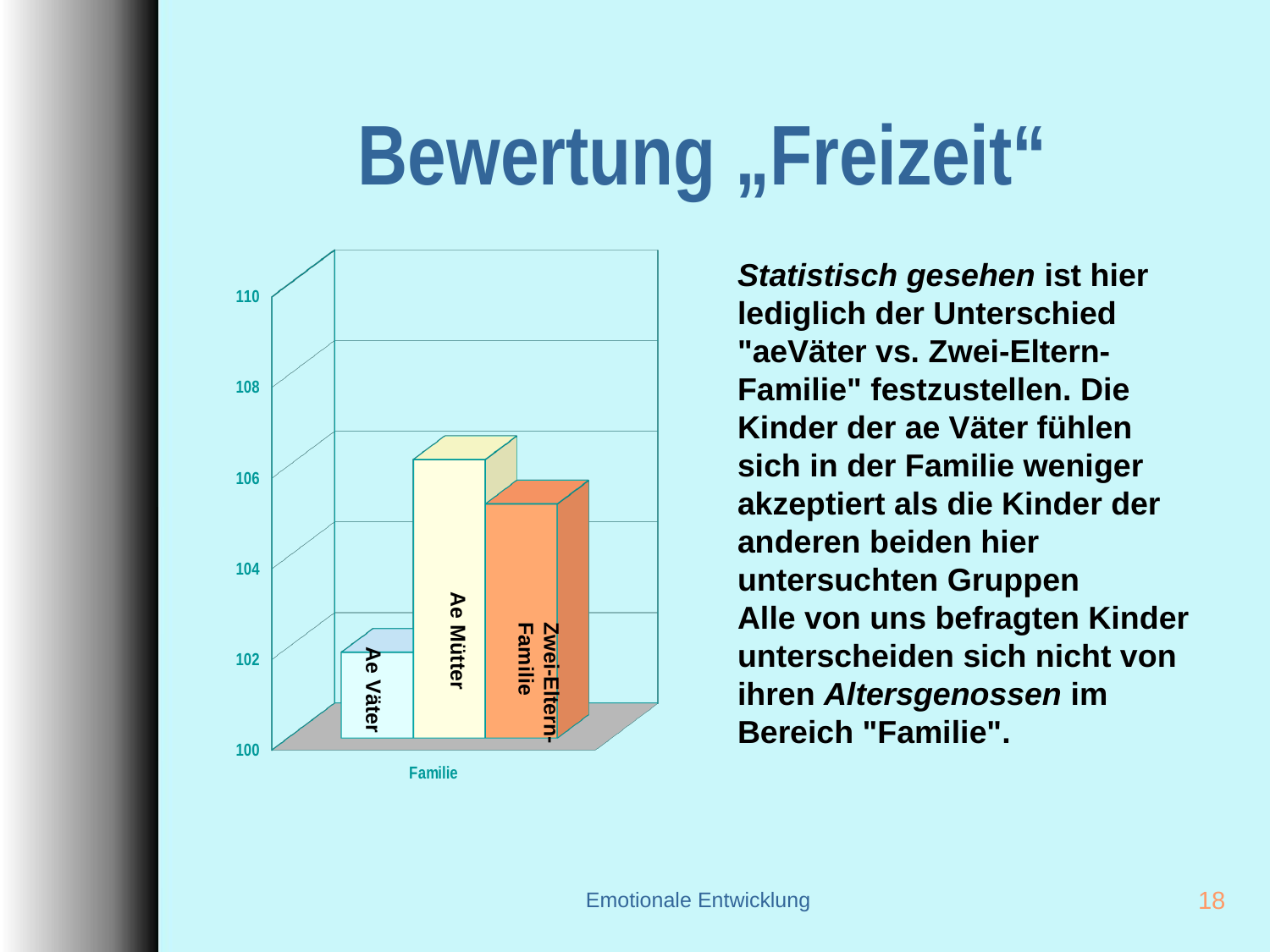
How many bars are plotted in the chart? 3 What kind of chart is shown on the slide? bar chart Which group has the lowest bar in the chart? Ae Väter Which bar is taller, Ae Väter or Zwei-Eltern-Familie? Zwei-Eltern-Familie What is the title of the slide containing the chart? Bewertung „Freizeit“ Is the value for Ae Mütter greater or less than 104? greater Is the value for Zwei-Eltern-Familie greater or less than 108? less Is the value for Ae Väter greater or less than 104? less Which bar is taller, Ae Mütter or Zwei-Eltern-Familie? Ae Mütter Which group has the highest bar in the chart? Ae Mütter What label is shown on the category axis below the bars? Familie